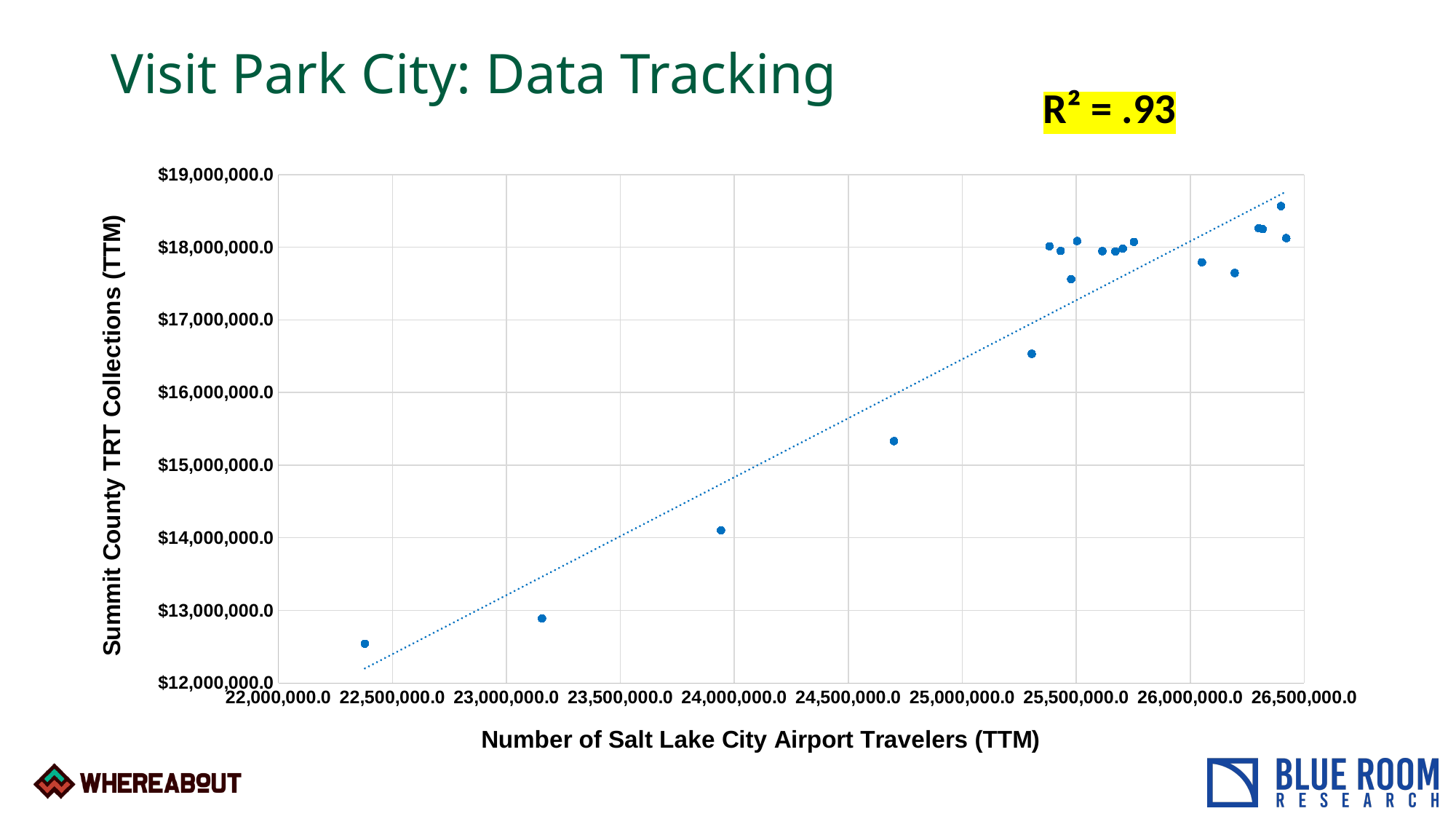
What is the title of the x axis of the chart? Number of Salt Lake City Airport Travelers (TTM) What is the lowest value shown on the y axis of the chart? $12,000,000.0 What is the highest value shown on the x axis of the chart? 26,500,000.0 Is the TRT collections value for the point plotted near 24,700,000 airport travelers greater or less than $15,000,000.0? greater What kind of chart is shown on the slide? Scatter chart Is the TRT collections value for the highest point on the chart greater or less than $18,000,000.0? greater Is the TRT collections value for the leftmost point on the chart greater or less than $13,000,000.0? less Do the plotted TRT collections generally rise or fall as the number of airport travelers increases along the x axis? Rise